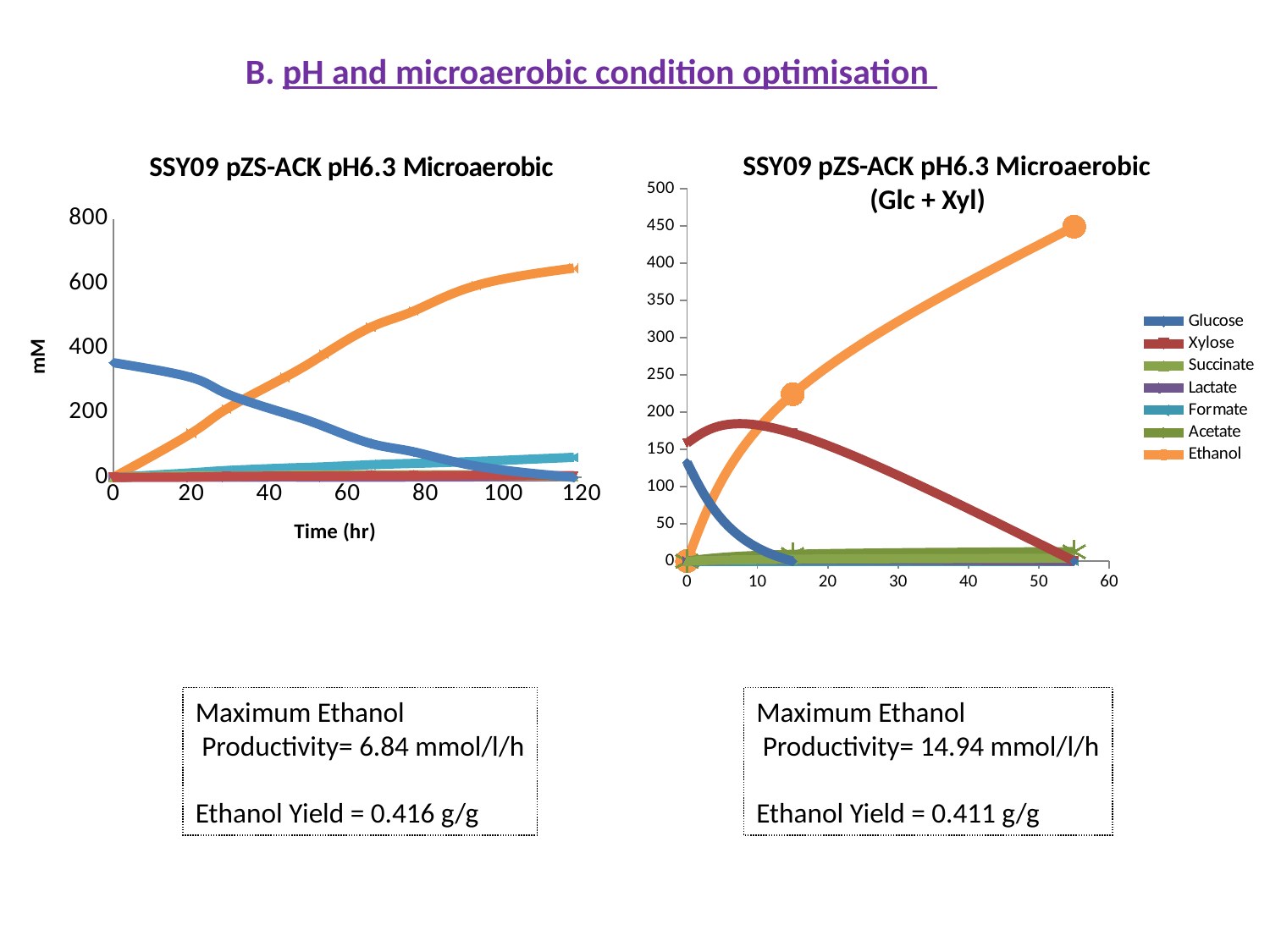
In the right chart 'SSY09 pZS-ACK pH6.3 Microaerobic (Glc + Xyl)', does the Xylose series rise or fall between 10 hr and 55 hr? fall In the right chart 'SSY09 pZS-ACK pH6.3 Microaerobic (Glc + Xyl)', which is larger at 0 hr, Glucose or Xylose? Xylose In the left chart 'SSY09 pZS-ACK pH6.3 Microaerobic', is the Ethanol value at 120 hr greater or less than 600 mM? greater What is the x-axis label of the left chart 'SSY09 pZS-ACK pH6.3 Microaerobic'? Time (hr) In the left chart 'SSY09 pZS-ACK pH6.3 Microaerobic', does the Ethanol series rise or fall as time increases? rise In the right chart 'SSY09 pZS-ACK pH6.3 Microaerobic (Glc + Xyl)', is the Xylose value at 0 hr greater or less than 100? greater How many series does the legend on the slide list? 7 What kind of chart is the left chart titled 'SSY09 pZS-ACK pH6.3 Microaerobic'? line chart In the right chart 'SSY09 pZS-ACK pH6.3 Microaerobic (Glc + Xyl)', is the final Ethanol value (around 55 hr) greater or less than 400? greater